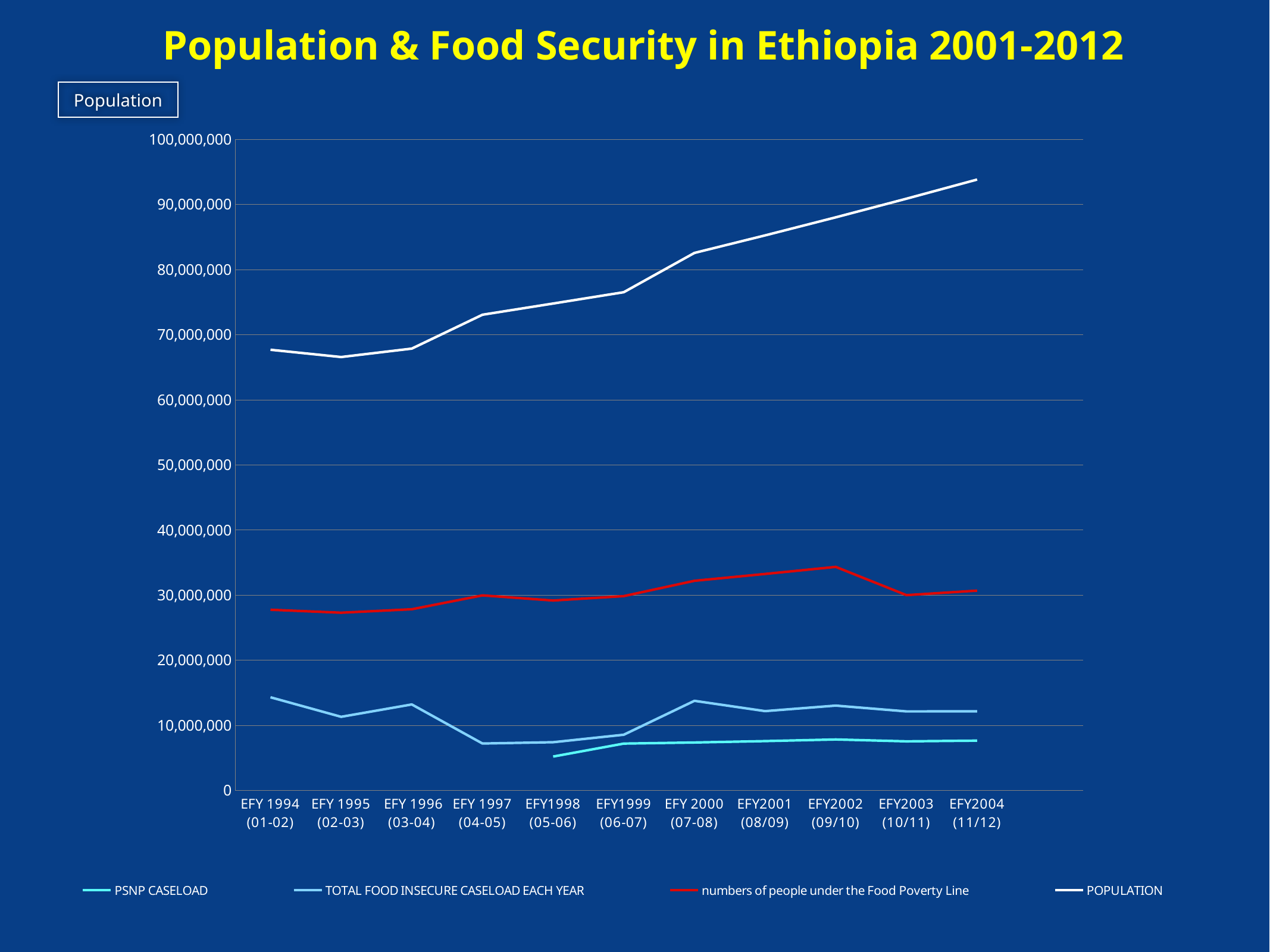
What kind of chart is shown on the slide? line chart Which colour is used for the POPULATION line? white In which year is the PSNP CASELOAD series at its lowest? EFY1998 (05-06) Does the POPULATION series rise or fall from EFY 1994 to EFY2004? rise Which is larger for the 'numbers of people under the Food Poverty Line' series: the value for EFY2002 or the value for EFY2003? EFY2002 In which year does the 'numbers of people under the Food Poverty Line' series reach its highest value? EFY2002 (09/10) In which year is the POPULATION series at its highest? EFY2004 (11/12) Is the POPULATION value for EFY2004 greater or less than 90,000,000? greater Is the value of 'numbers of people under the Food Poverty Line' for EFY2002 greater or less than 30,000,000? greater Is the POPULATION value for EFY 1994 greater or less than 70,000,000? less How many fiscal-year categories are shown on the x axis? 11 How many series does the legend list? 4